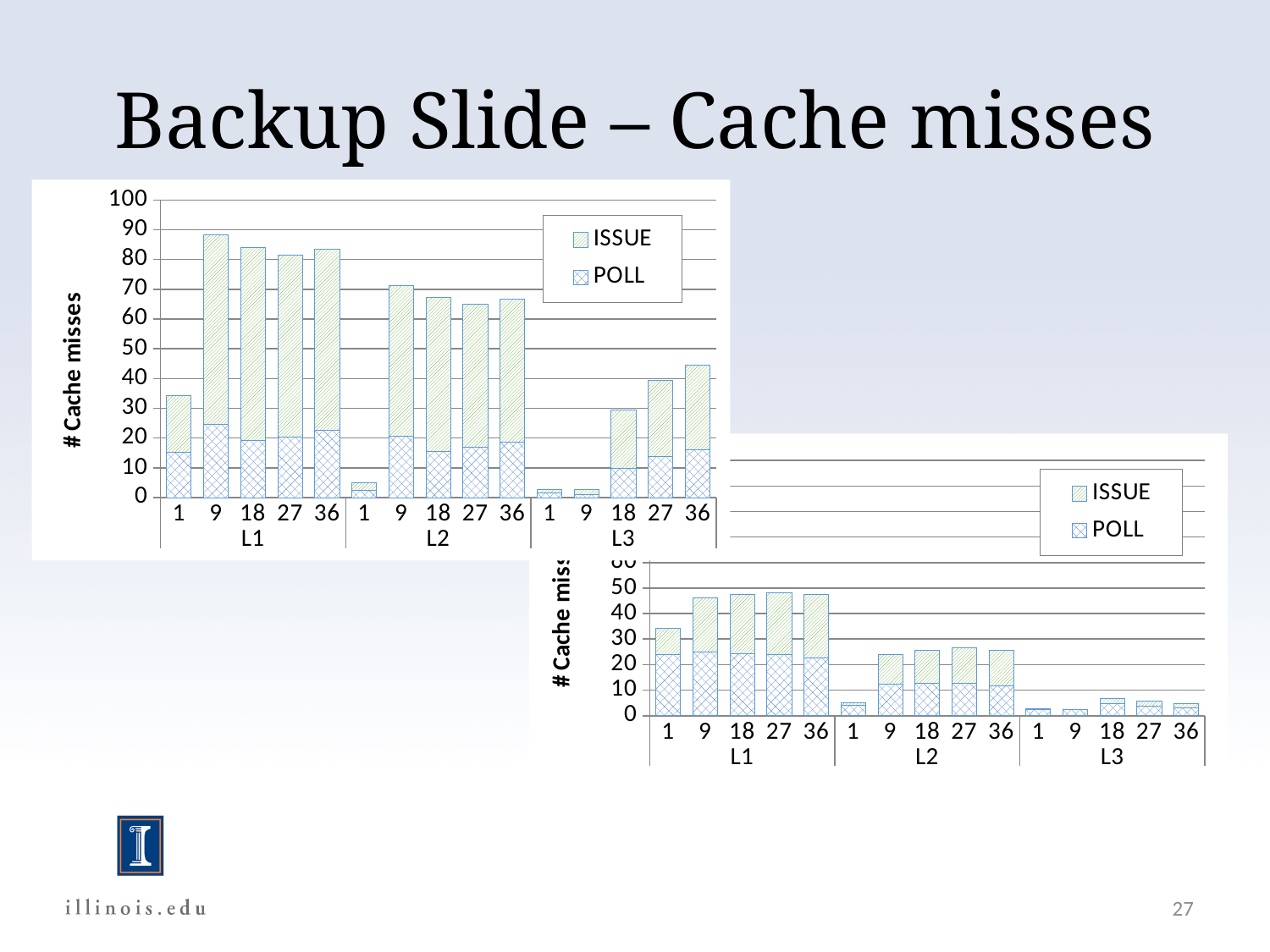
What is the y-axis title of the top-left chart? # Cache misses In the bottom-right chart, which total is larger: L1 at 1 or L2 at 9? L1 at 1 What kind of chart is the top-left chart? Stacked bar chart In the top-left chart, is the total value for L2 at 1 greater or less than 10? less How many bars are plotted in the bottom-right chart? 15 What are the two legend entries in the bottom-right chart? ISSUE and POLL In the top-left chart, is the total value for L1 at 9 greater or less than 80? greater In the top-left chart, within the L3 group, do the totals rise or fall from 1 to 36? rise How many series does the legend of the top-left chart list? 2 In the bottom-right chart, is the total value for L3 at 18 greater or less than 10? less